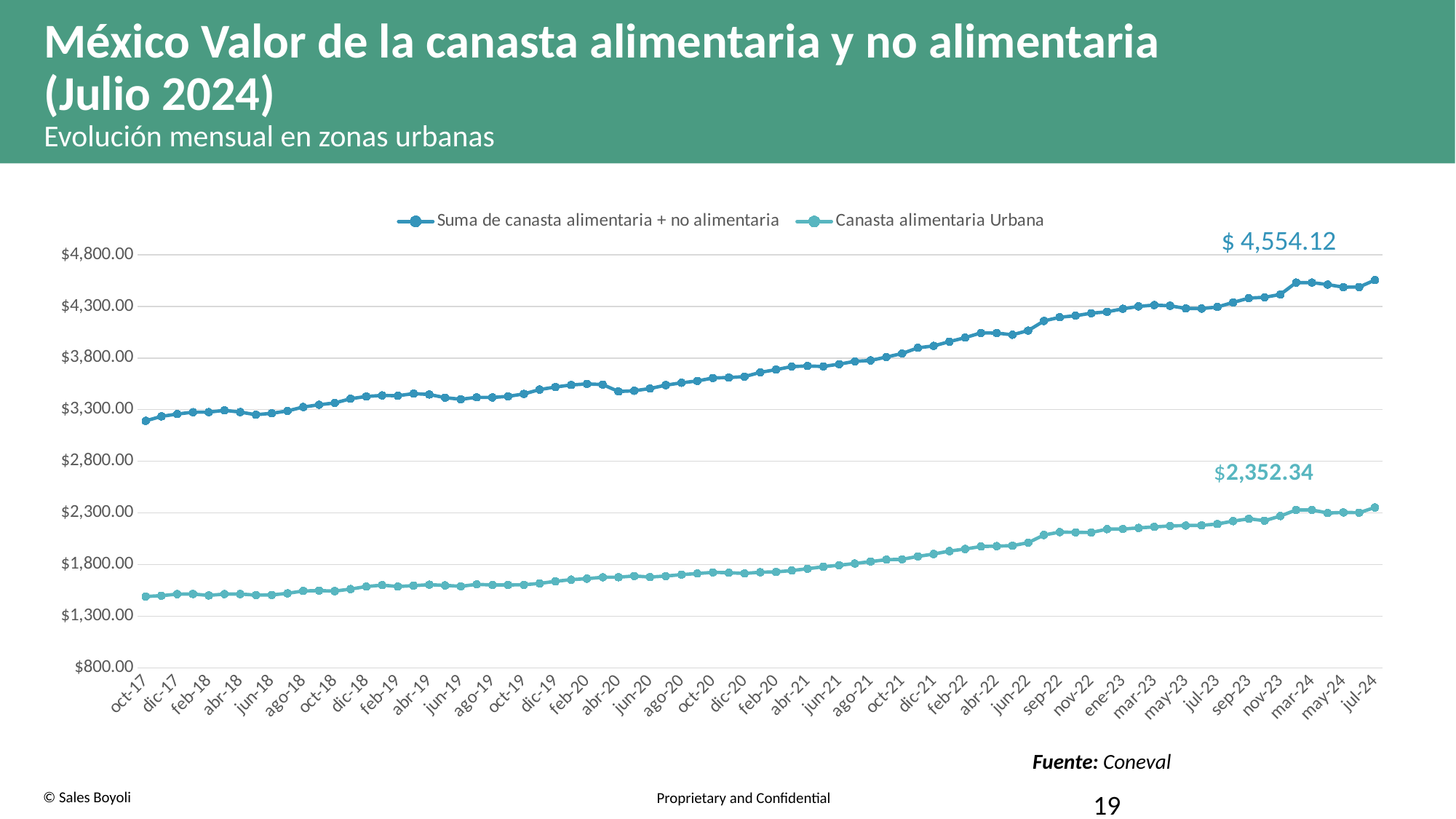
How many series does the legend list? 2 What kind of chart is shown on the slide? Line chart Is the value for "Suma de canasta alimentaria + no alimentaria" in jun-22 greater or less than $3,800.00? greater What is the value of "Canasta alimentaria Urbana" in jul-24? $2,352.34 Is the value for "Suma de canasta alimentaria + no alimentaria" in oct-17 greater or less than $3,300.00? less What is the value of "Suma de canasta alimentaria + no alimentaria" in jul-24? $ 4,554.12 What is the difference between the two labelled jul-24 values, $ 4,554.12 and $2,352.34? $2,201.78 What source is cited for the chart data? Coneval Which series has the higher value in jul-24? Suma de canasta alimentaria + no alimentaria In which month is the value of "Suma de canasta alimentaria + no alimentaria" lowest? oct-17 Is the value for "Canasta alimentaria Urbana" in jun-22 greater or less than $2,300.00? less Do the values of "Canasta alimentaria Urbana" generally rise or fall from oct-17 to jul-24? Rise